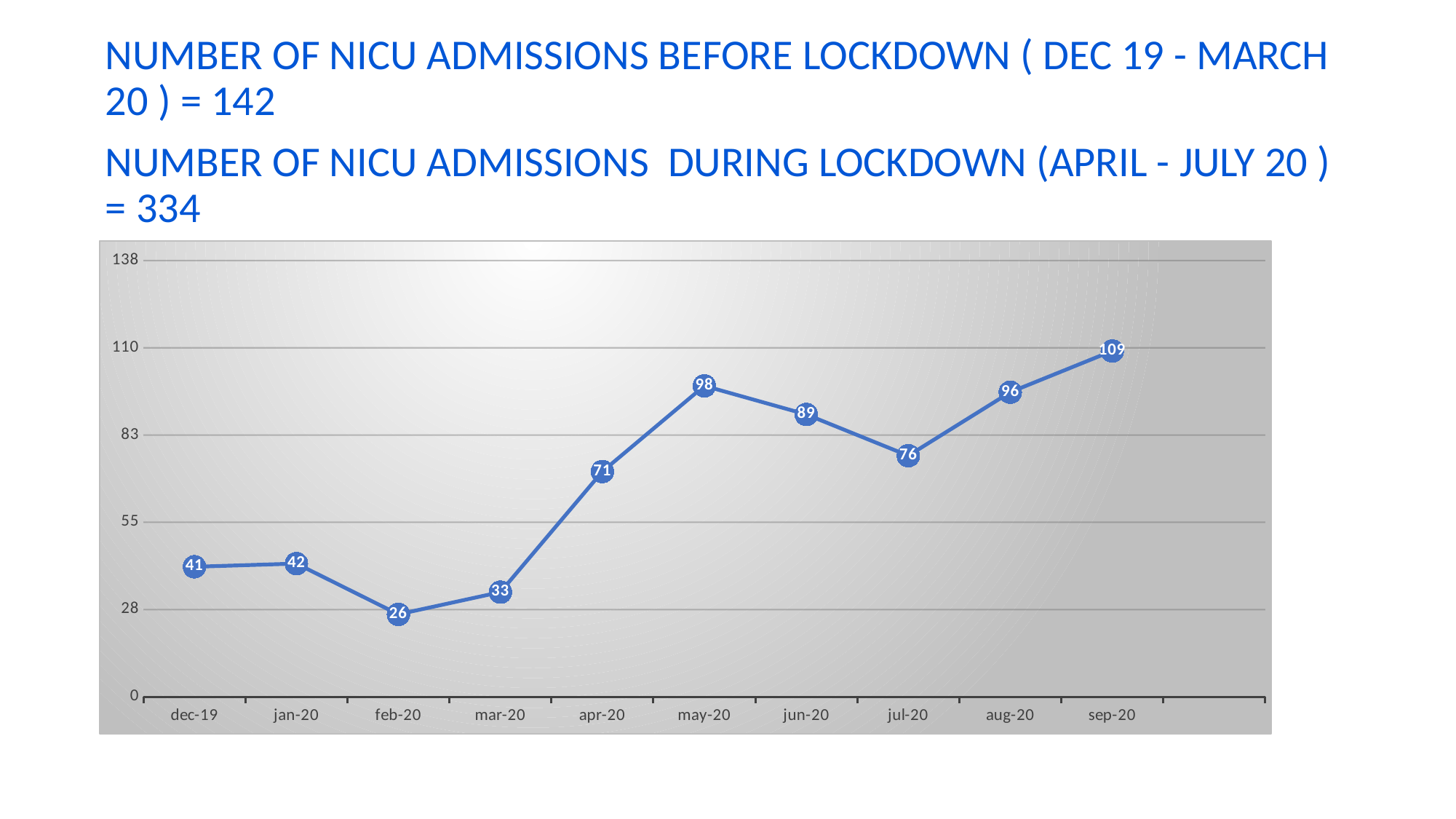
Which month has the lowest value? feb-20 What is the value for may-20? 98 Which month has the highest value? sep-20 What is the value for feb-20? 26 What is the difference between the values for may-20 and apr-20? 27 How many months are plotted on the x axis? 10 Which is larger, the value for jun-20 or the value for aug-20? aug-20 What is the difference between the values for sep-20 and dec-19? 68 What is the value for sep-20? 109 Do the values rise or fall from mar-20 to may-20? rise Is the value for jul-20 greater or less than 83? less What kind of chart is shown on the slide? line chart